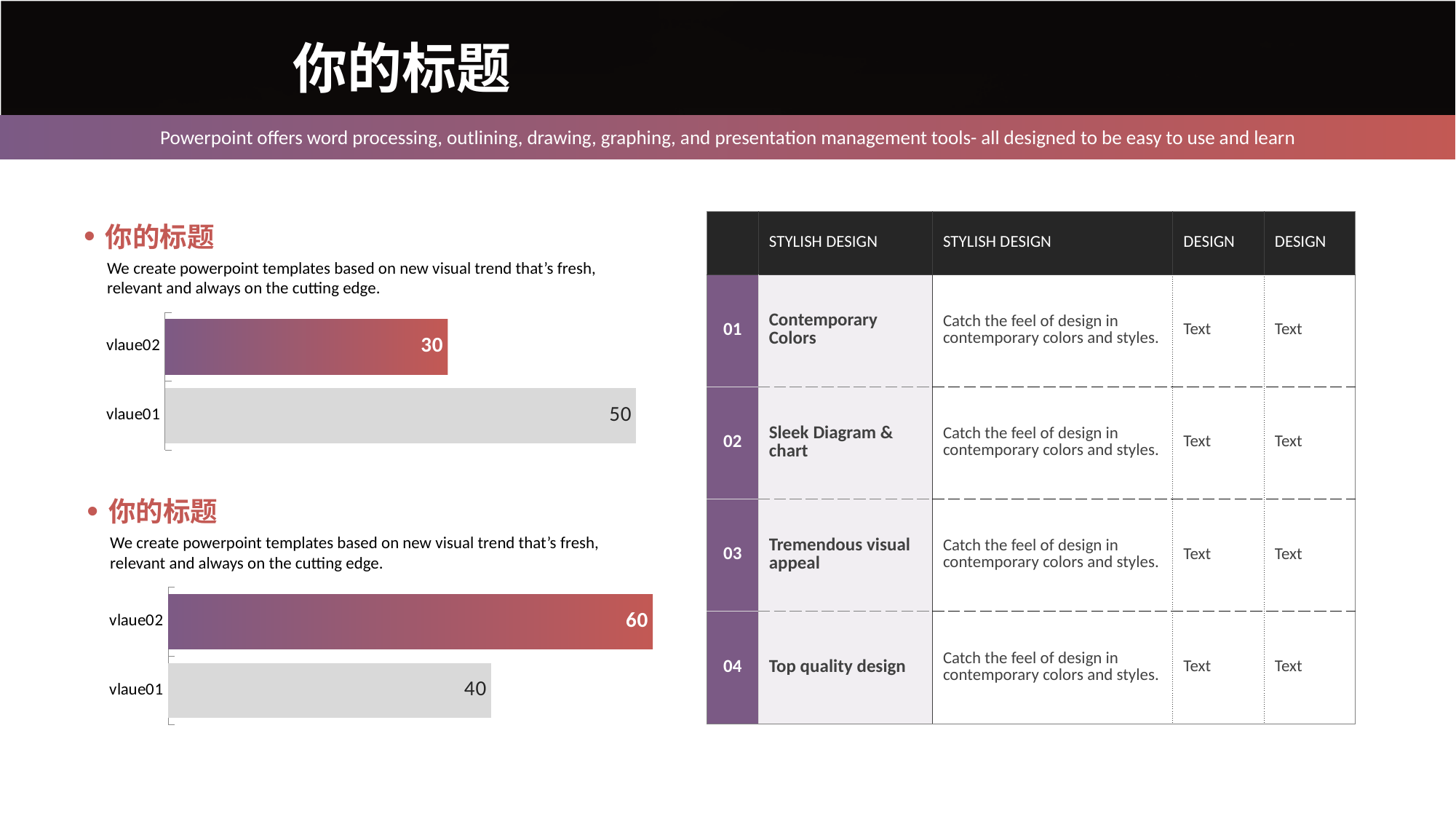
In the lower bar chart on the left, which is larger, vlaue02 or vlaue01? vlaue02 In the upper bar chart on the left, what is the value for vlaue01? 50 In the upper bar chart on the left, which bar is coloured with a purple-to-red gradient? vlaue02 In the lower bar chart on the left, what is the difference between the values for vlaue02 and vlaue01? 20 In the upper bar chart on the left, what is the value for vlaue02? 30 In the upper bar chart on the left, which category has the highest value? vlaue01 In the upper bar chart on the left, what is the difference between the values for vlaue01 and vlaue02? 20 How many categories does the upper bar chart on the left show? 2 What kind of chart is the lower chart on the left? bar chart In the lower bar chart on the left, what is the value for vlaue01? 40 In the lower bar chart on the left, which category has the lowest value? vlaue01 In the lower bar chart on the left, what is the value for vlaue02? 60